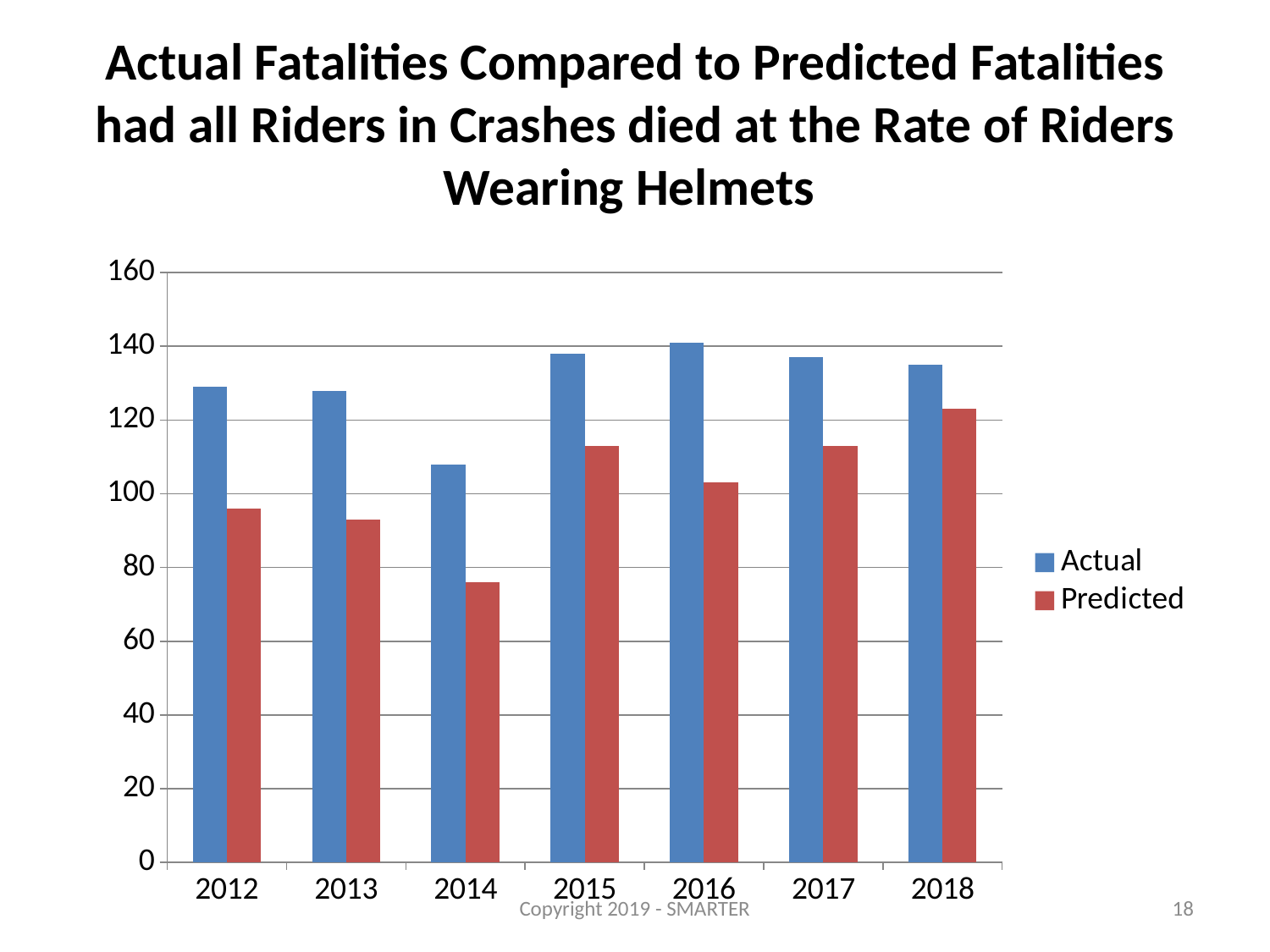
How many series does the legend list? 2 Is the Actual value for 2014 greater or less than 100? greater What kind of chart is shown on the slide? bar chart Which colour represents the Predicted series in the legend? red Is the Predicted value for 2014 greater or less than 80? less Is the Predicted value for 2012 greater or less than 100? less How many years are shown on the x axis? 7 Which year has the lowest Actual fatalities? 2014 Which year has the highest Predicted fatalities? 2018 In 2014, which is larger, the Actual or the Predicted value? Actual Which year has the lowest Predicted fatalities? 2014